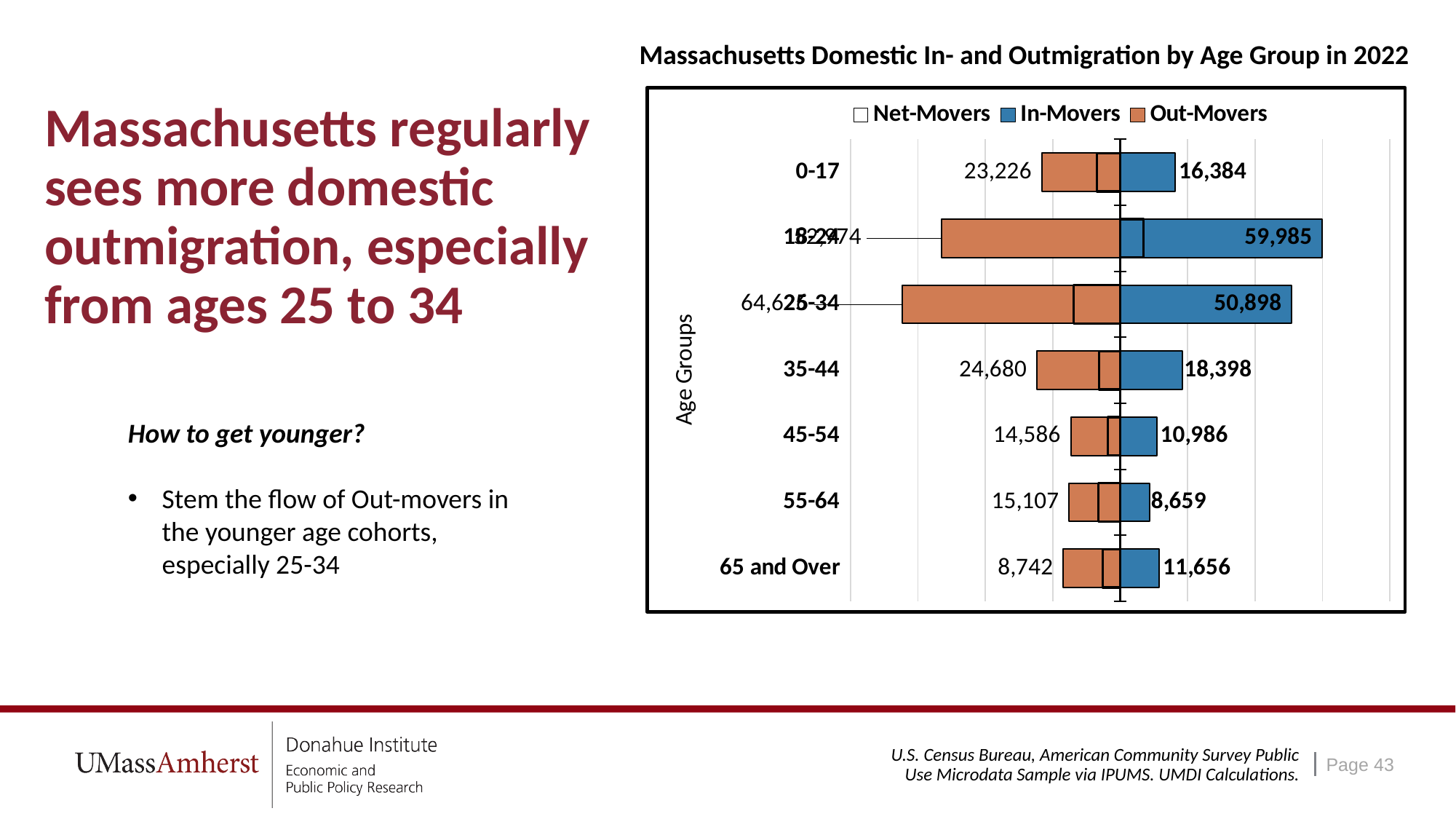
Which age group has the lowest In-Movers value? 55-64 What is the In-Movers value for the 18-24 age group? 59,985 How many series does the chart legend list? 3 What kind of chart is shown on the slide? bar chart Which age group has the highest In-Movers value? 18-24 What is the title of the chart? Massachusetts Domestic In- and Outmigration by Age Group in 2022 What is the Out-Movers value for the 45-54 age group? 14,586 How many age groups are shown on the chart? 7 What is the Out-Movers value for the 0-17 age group? 23,226 For the 35-44 age group, how much larger is the Out-Movers value than the In-Movers value? 6,282